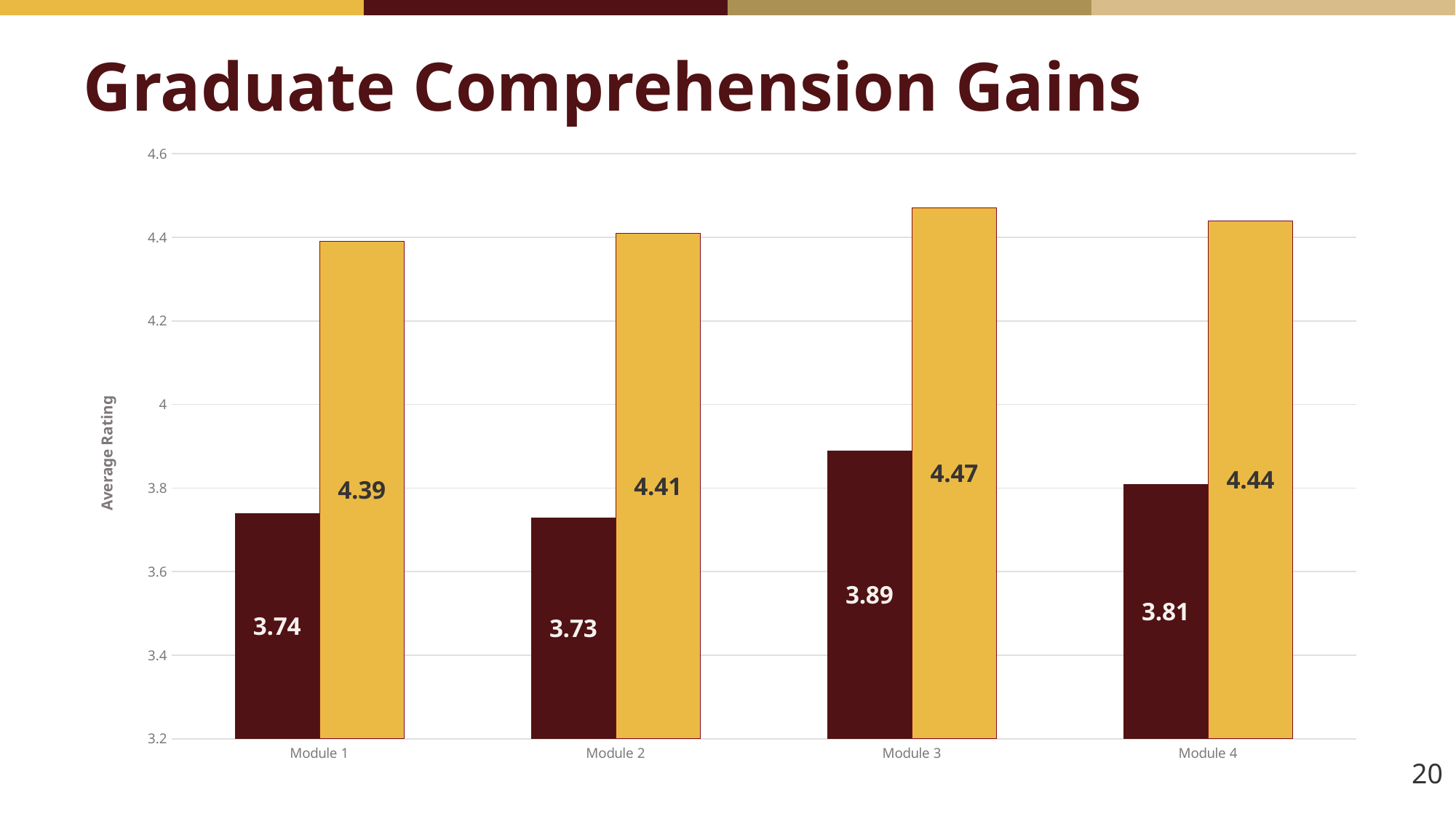
Which is larger: the dark red bar for Module 3 or the dark red bar for Module 4? Module 3 What is the difference between the gold bar values for Module 3 and Module 1? 0.08 What is the difference between the gold bar and the dark red bar for Module 4? 0.63 Is the gold bar value for Module 1 greater or less than 4.2? greater Which module has the highest gold bar value? Module 3 What kind of chart is shown on the slide? bar chart What is the value of the dark red bar for Module 1? 3.74 What is the value of the gold bar for Module 2? 4.41 What is the value of the dark red bar for Module 3? 3.89 What is the title of the chart? Graduate Comprehension Gains Which module has the lowest dark red bar value? Module 2 How many modules are shown on the x axis? 4